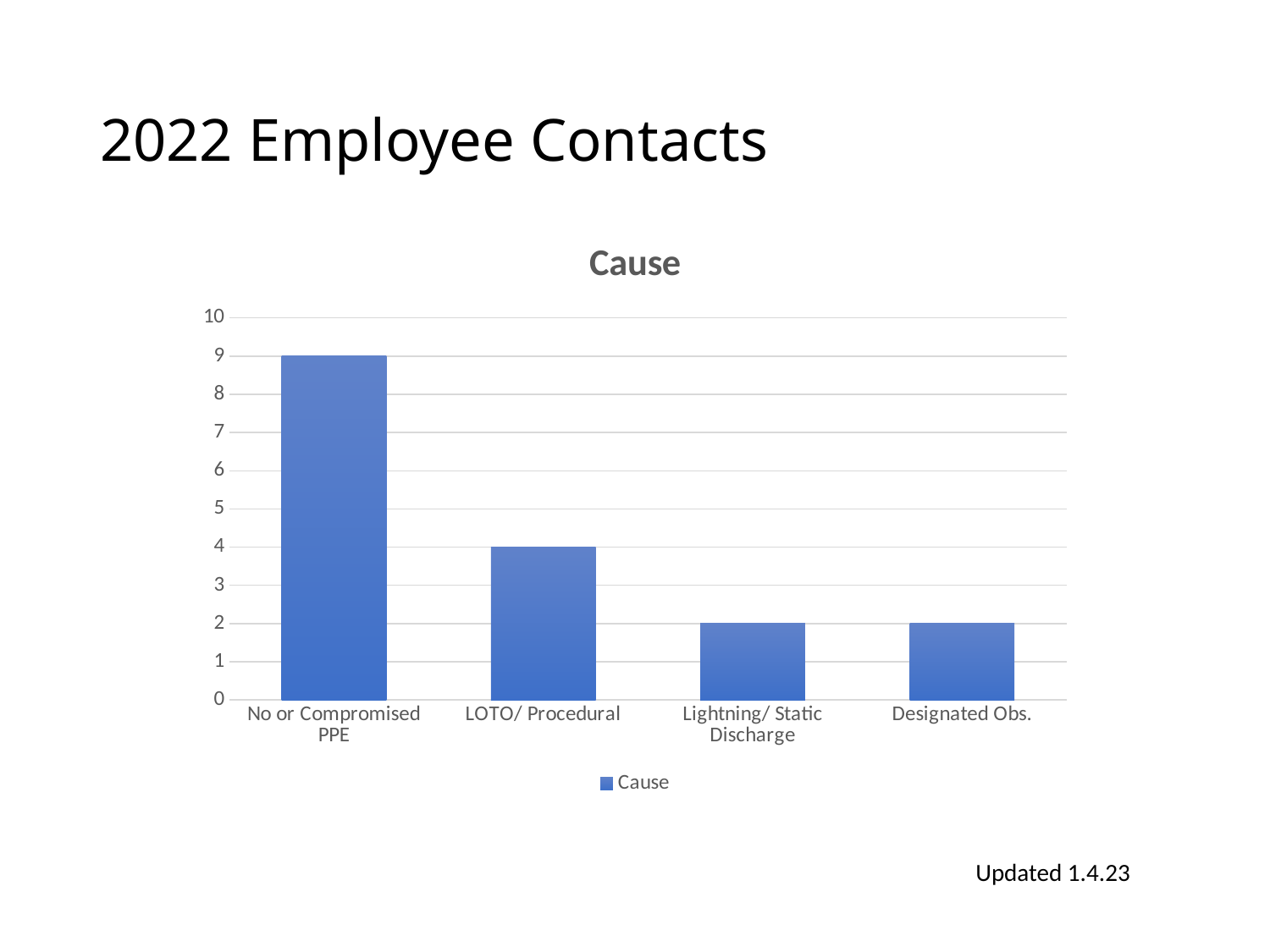
How many categories are shown on the x axis? 4 Is the value for LOTO/ Procedural greater or less than 5? less What is the value for Designated Obs.? 2 What is the value for LOTO/ Procedural? 4 What is the difference between the values for No or Compromised PPE and LOTO/ Procedural? 5 Which is larger, the value for LOTO/ Procedural or the value for Designated Obs.? LOTO/ Procedural What kind of chart is shown on the slide? bar chart Which category has the highest value? No or Compromised PPE What is the value for No or Compromised PPE? 9 How many series does the legend list? 1 What is the value for Lightning/ Static Discharge? 2 What is the title of the chart? Cause